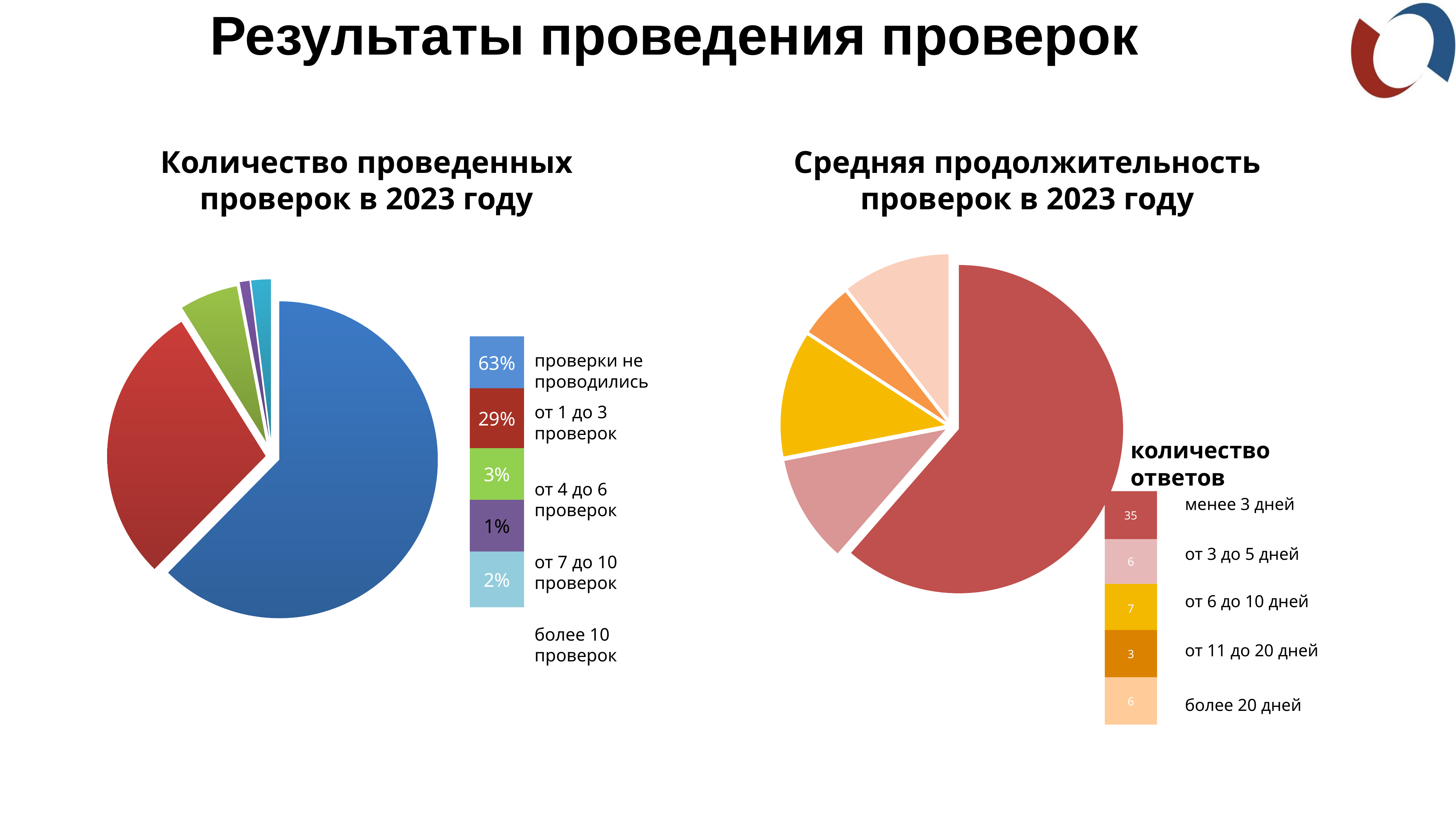
On the chart 'Средняя продолжительность проверок в 2023 году', which has more answers: 'от 6 до 10 дней' or 'более 20 дней'? от 6 до 10 дней On the chart 'Количество проведенных проверок в 2023 году', which category has the smallest share? от 7 до 10 проверок On the chart 'Средняя продолжительность проверок в 2023 году', how many answers correspond to 'от 6 до 10 дней'? 7 On the chart 'Средняя продолжительность проверок в 2023 году', what colour is the slice for 'от 6 до 10 дней'? Yellow On the chart 'Количество проведенных проверок в 2023 году', what is the difference between the shares for 'проверки не проводились' and 'от 1 до 3 проверок'? 34% On the chart 'Средняя продолжительность проверок в 2023 году', what is the total number of answers across all categories? 57 On the chart 'Средняя продолжительность проверок в 2023 году', how many answers correspond to 'менее 3 дней'? 35 On the chart 'Количество проведенных проверок в 2023 году', how many categories are shown in the legend? 5 On the chart 'Количество проведенных проверок в 2023 году', what percentage corresponds to 'от 1 до 3 проверок'? 29% What type of chart is 'Средняя продолжительность проверок в 2023 году'? Pie chart On the chart 'Количество проведенных проверок в 2023 году', what percentage corresponds to 'проверки не проводились'? 63% On the chart 'Средняя продолжительность проверок в 2023 году', which category has the fewest answers? от 11 до 20 дней